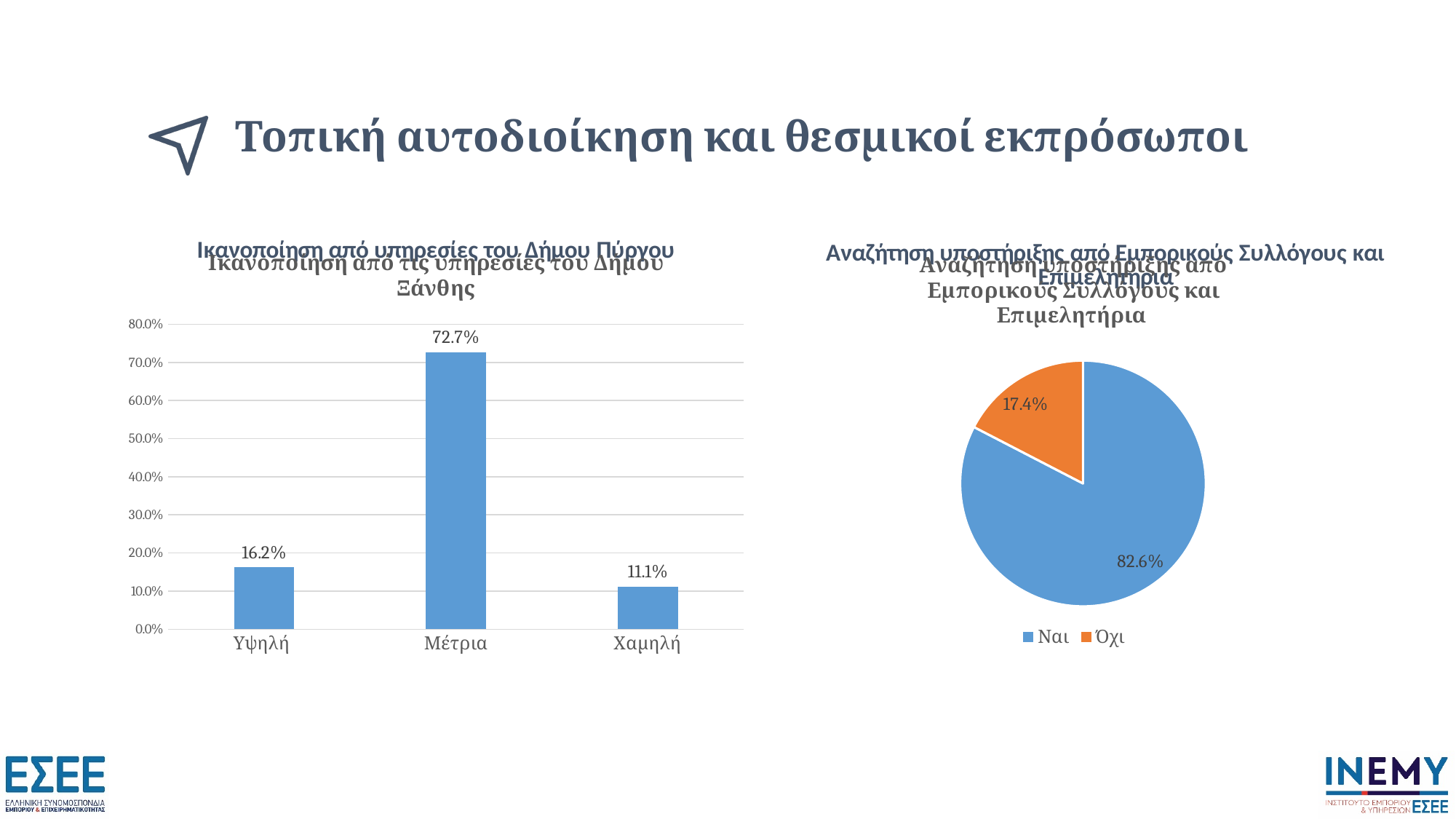
In the bar chart on the left, which is larger, the value for Υψηλή or the value for Χαμηλή? Υψηλή In the bar chart on the left, what is the value for Υψηλή? 16.2% In the bar chart on the left, what is the value for Χαμηλή? 11.1% In the pie chart on the right, how many entries does the legend list? 2 In the bar chart on the left, what is the difference between the values for Μέτρια and Υψηλή? 56.5% In the bar chart on the left, how many categories are shown on the x axis? 3 In the pie chart on the right, what share does Όχι have? 17.4% What kind of chart is the chart on the left of the slide? Bar chart In the bar chart on the left, which category has the lowest value? Χαμηλή In the bar chart on the left, which category has the highest value? Μέτρια In the bar chart on the left, what is the value for Μέτρια? 72.7% In the pie chart on the right, what share does Ναι have? 82.6%